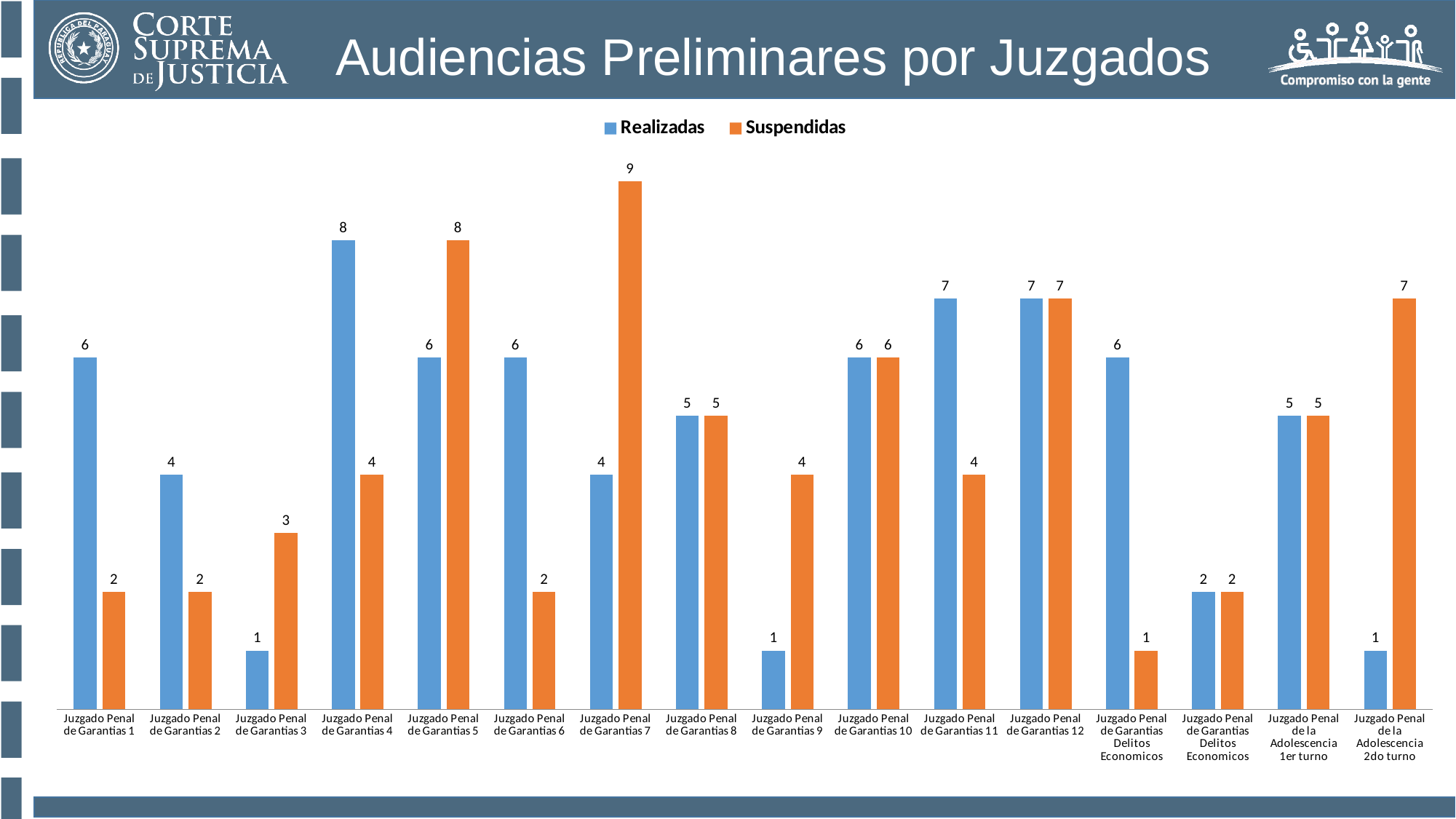
Which juzgado has the highest Realizadas value? Juzgado Penal de Garantias 4 What are the two series named in the legend? Realizadas and Suspendidas How many juzgados (categories) are shown on the x axis? 16 What is the difference between Suspendidas and Realizadas for Juzgado Penal de Garantias 5? 2 How many series does the legend list? 2 For Juzgado Penal de Garantias 11, which is larger, Realizadas or Suspendidas? Realizadas What is the Suspendidas value for Juzgado Penal de Garantias 7? 9 What type of chart is shown on the slide? bar chart What is the Realizadas value for Juzgado Penal de la Adolescencia 2do turno? 1 What is the title of the chart? Audiencias Preliminares por Juzgados What is the Realizadas value for Juzgado Penal de Garantias 4? 8 Which juzgado has the highest Suspendidas value? Juzgado Penal de Garantias 7